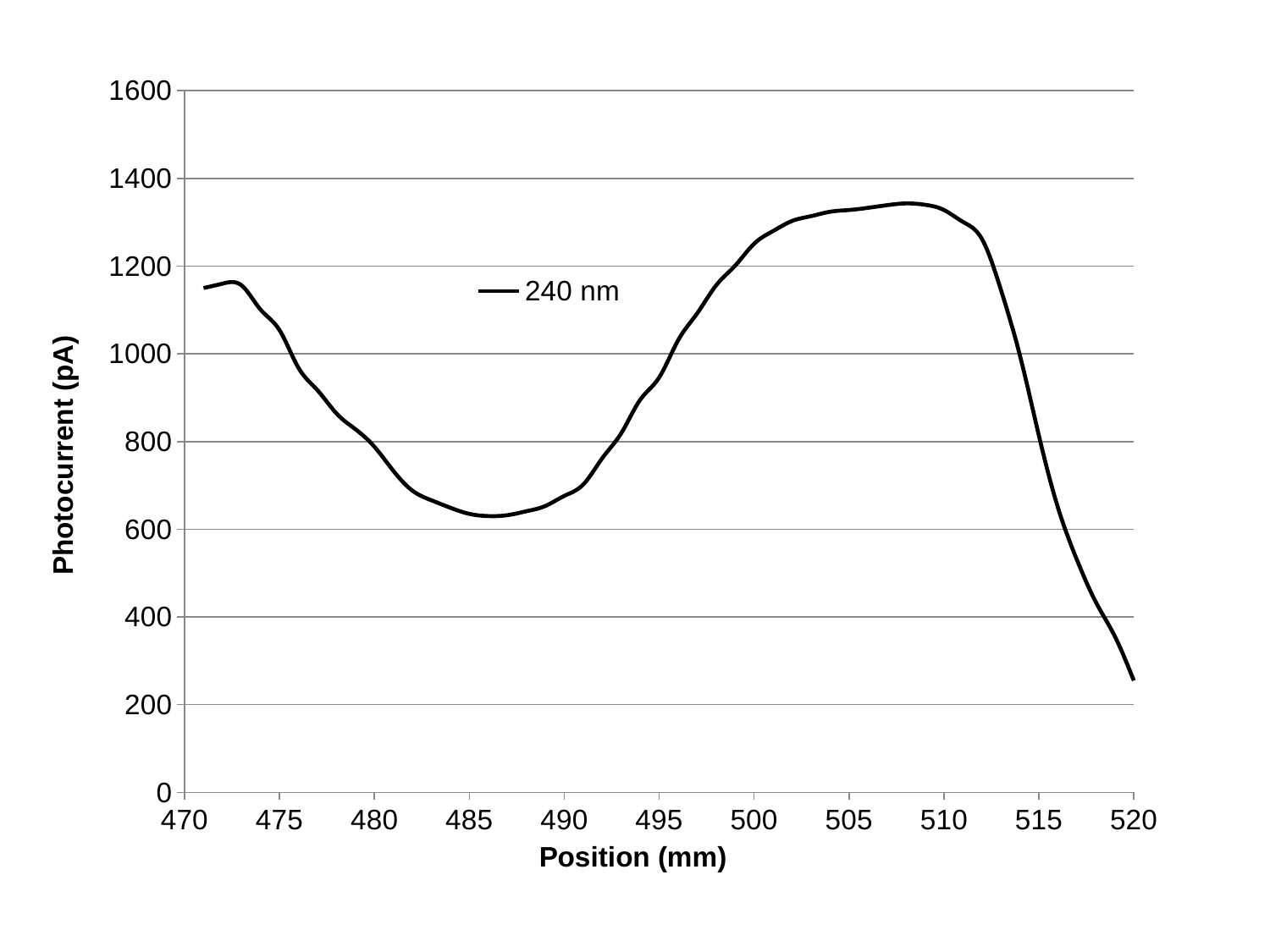
Is the photocurrent at a position of 520 mm greater or less than 400? less Is the photocurrent at a position of 490 mm greater or less than 800? less What is the title of the y axis? Photocurrent (pA) Is the photocurrent at a position of 505 mm greater or less than 1200? greater What kind of chart is shown on the slide? line chart How many series does the legend list? 1 What is the name of the series shown in the legend? 240 nm Which position has the larger photocurrent, 485 mm or 505 mm? 505 mm Does the photocurrent rise or fall as the position increases from 475 mm to 485 mm? fall Does the photocurrent rise or fall as the position increases from 490 mm to 505 mm? rise